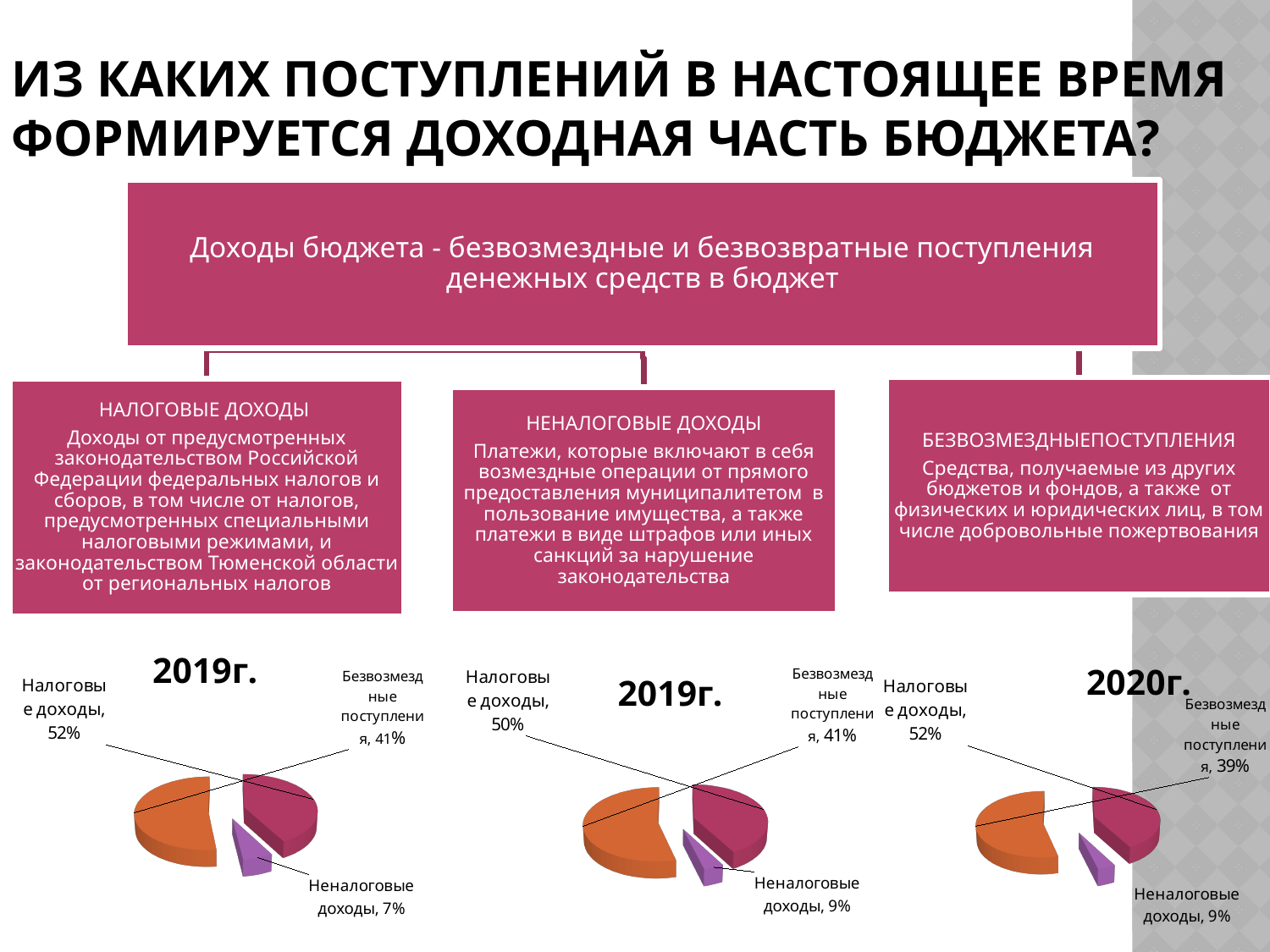
In the right pie chart titled 2020г., what share is Безвозмездные поступления? 39% In the right pie chart titled 2020г., what is the difference between the shares of Налоговые доходы and Безвозмездные поступления? 13% In the left pie chart titled 2019г., which category has the smallest share? Неналоговые доходы In the left pie chart titled 2019г., what share is Налоговые доходы? 52% In the left pie chart titled 2019г., what share is Неналоговые доходы? 7% How many categories does the right pie chart titled 2020г. show? 3 In the middle pie chart titled 2019г., which is larger: Налоговые доходы or Безвозмездные поступления? Налоговые доходы In the right pie chart titled 2020г., which category has the largest share? Налоговые доходы In the middle pie chart titled 2019г., what share is Налоговые доходы? 50% How many pie charts are shown on the slide? 3 What type of chart is the left chart titled 2019г.? Pie chart In the middle pie chart titled 2019г., what share is Неналоговые доходы? 9%